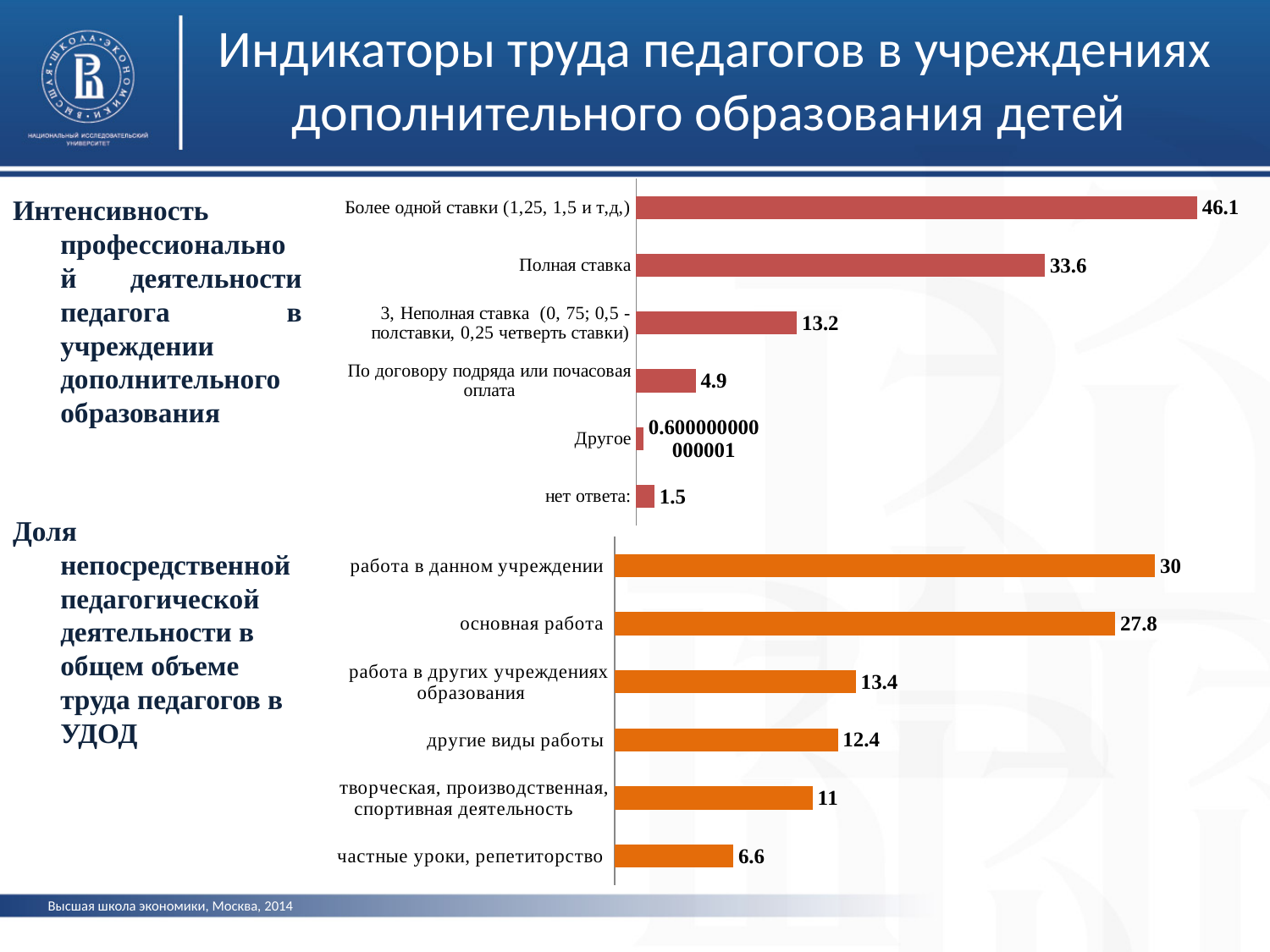
In the bottom chart (orange bars), which category has the lowest value? частные уроки, репетиторство In the top chart (red bars), how many categories are shown? 6 What type of chart is the bottom chart (orange bars)? bar chart In the bottom chart (orange bars), how many categories are shown? 6 In the top chart (red bars), what is the value for "По договору подряда или почасовая оплата"? 4.9 In the bottom chart (orange bars), what is the difference between the values for "работа в других учреждениях образования" and "другие виды работы"? 1 In the top chart (red bars), what is the value for "Полная ставка"? 33.6 In the top chart (red bars), which is larger: the value for "нет ответа:" or the value for "Другое"? нет ответа: In the top chart (red bars), which category has the highest value? Более одной ставки (1,25, 1,5 и т,д,) In the bottom chart (orange bars), what is the value for "основная работа"? 27.8 In the top chart (red bars), what is the difference between the values for "Более одной ставки" and "Полная ставка"? 12.5 In the bottom chart (orange bars), what is the value for "частные уроки, репетиторство"? 6.6